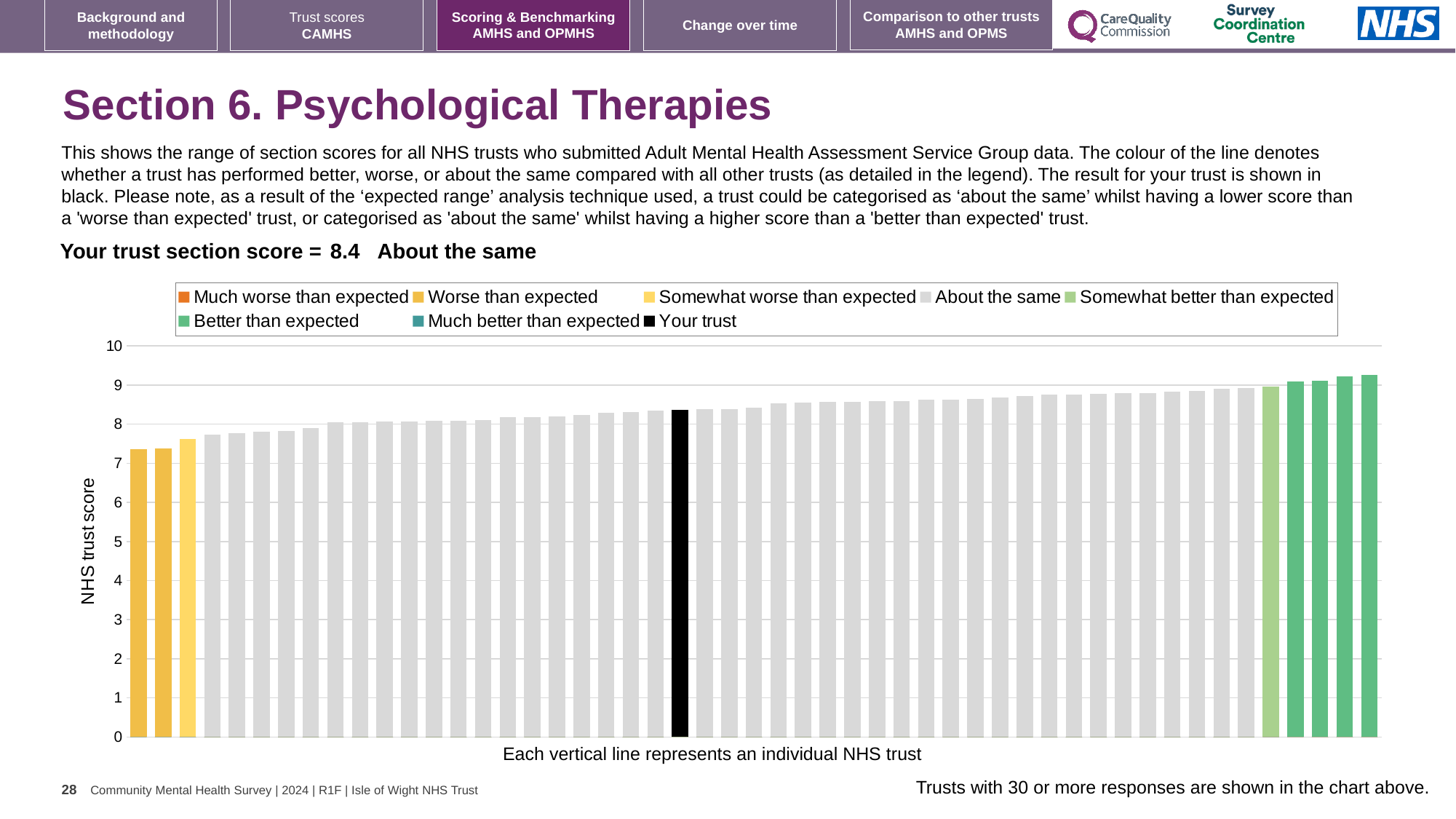
Which is larger: the value of the black 'Your trust' bar or the value of the leftmost bar? Your trust What kind of chart is shown on the slide? bar chart Is the value of the rightmost bar greater or less than 9? greater Do the bar values rise or fall from left to right along the x axis? rise Is the value of the leftmost bar greater or less than 8? less How many bars are coloured as 'Better than expected' (dark green)? 4 Which performance category is your trust placed in for this section? About the same What is the label on the vertical axis of the chart? NHS trust score How many entries does the chart legend list? 8 What is the section score for your trust shown on the slide? 8.4 How many bars are coloured as 'Worse than expected' (dark yellow)? 2 Is the value of the black 'Your trust' bar greater or less than 8? greater